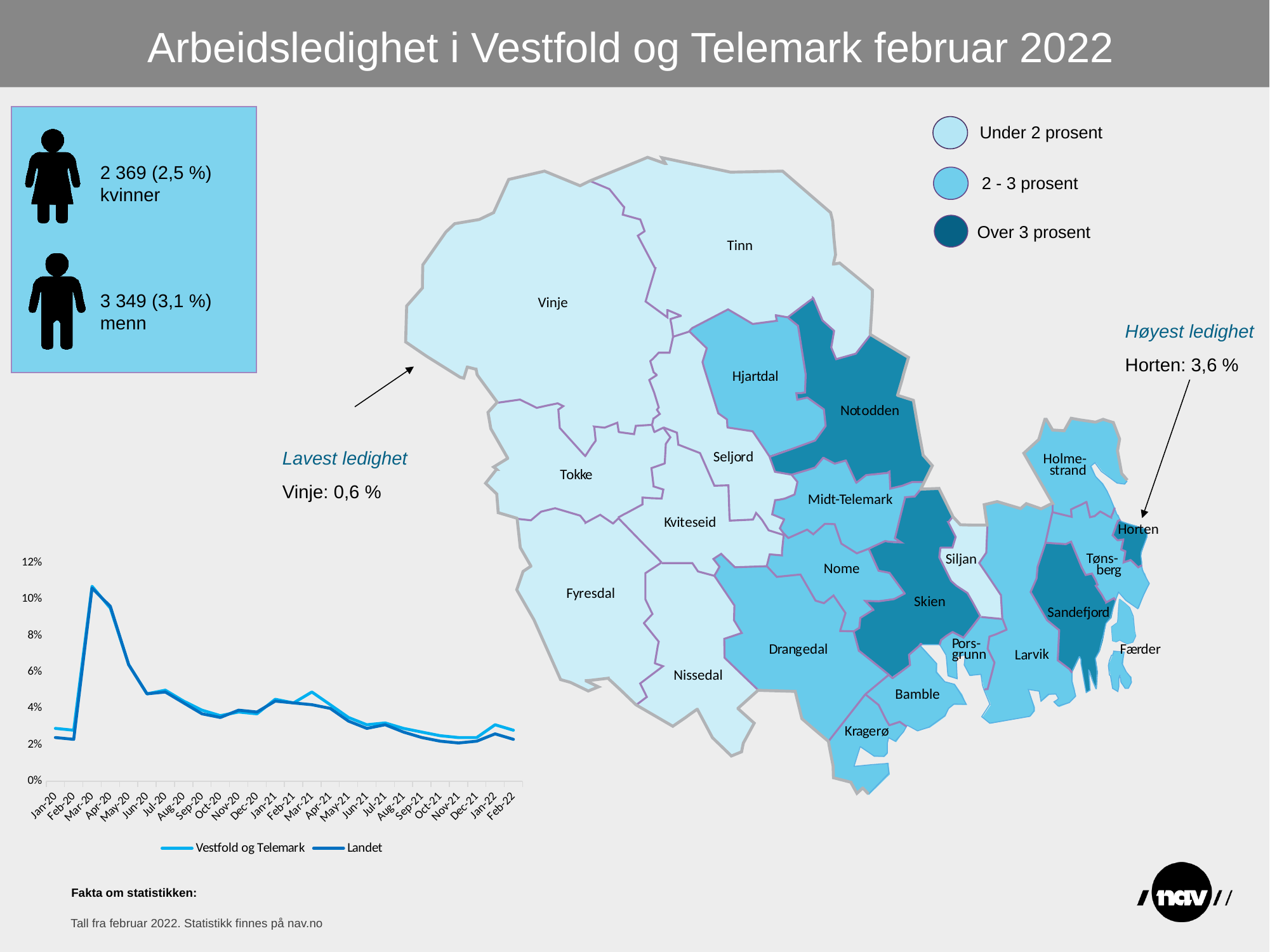
In the line chart, is the Vestfold og Telemark value for Feb-22 greater or less than 4%? less What kind of chart is shown at the bottom left of the slide? line chart In the line chart, which series has the higher value in Mar-21, Vestfold og Telemark or Landet? Vestfold og Telemark In the line chart, is the Vestfold og Telemark value for Jan-20 greater or less than 4%? less In the line chart, is the Landet value for Mar-20 greater or less than 10%? greater How many months are shown on the x axis of the line chart? 26 On the map, which municipality is marked as having the highest unemployment, and what is its rate? Horten: 3,6 % What are the two series named in the legend of the line chart? Vestfold og Telemark and Landet In the line chart, do the values generally rise or fall from Mar-20 to Feb-22? fall In the line chart, in which month does the Landet series reach its highest value? Mar-20 How many series does the legend of the line chart list? 2